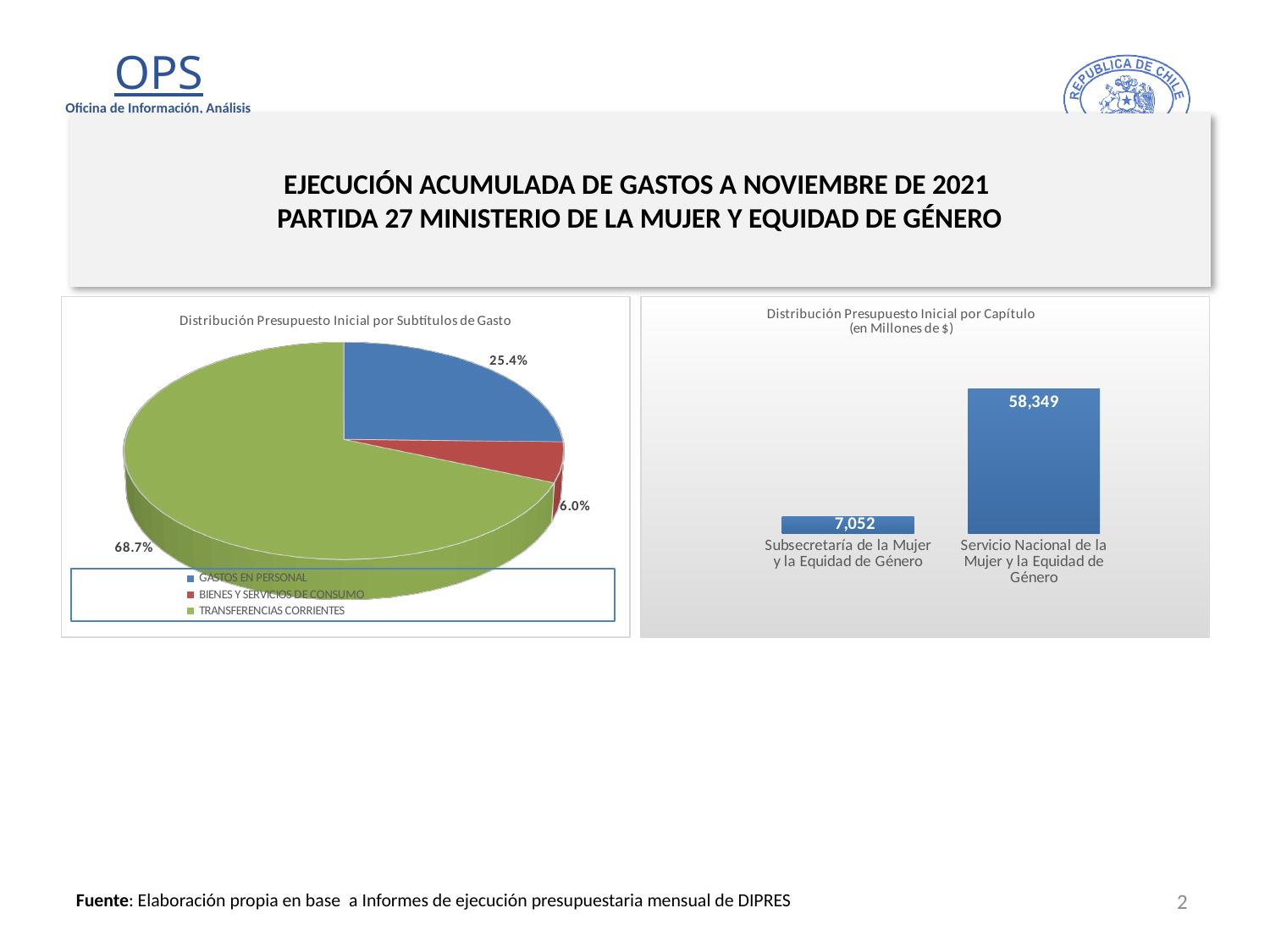
In the chart 'Distribución Presupuesto Inicial por Capítulo', what is the difference between the values for Servicio Nacional de la Mujer y la Equidad de Género and Subsecretaría de la Mujer y la Equidad de Género? 51,297 In the chart 'Distribución Presupuesto Inicial por Capítulo', what is the value for Servicio Nacional de la Mujer y la Equidad de Género? 58,349 In the chart 'Distribución Presupuesto Inicial por Capítulo', what is the value for Subsecretaría de la Mujer y la Equidad de Género? 7,052 In the pie chart 'Distribución Presupuesto Inicial por Subtítulos de Gasto', which category has the largest share? TRANSFERENCIAS CORRIENTES In the chart 'Distribución Presupuesto Inicial por Capítulo', which category has the higher value? Servicio Nacional de la Mujer y la Equidad de Género In the pie chart 'Distribución Presupuesto Inicial por Subtítulos de Gasto', what share does GASTOS EN PERSONAL have? 25.4% In the pie chart 'Distribución Presupuesto Inicial por Subtítulos de Gasto', which category has the smallest share? BIENES Y SERVICIOS DE CONSUMO In the pie chart 'Distribución Presupuesto Inicial por Subtítulos de Gasto', what share does TRANSFERENCIAS CORRIENTES have? 68.7% In the pie chart 'Distribución Presupuesto Inicial por Subtítulos de Gasto', what colour is the TRANSFERENCIAS CORRIENTES slice? Green In the pie chart 'Distribución Presupuesto Inicial por Subtítulos de Gasto', how many categories does the legend list? 3 What kind of chart is 'Distribución Presupuesto Inicial por Capítulo'? Bar chart In the pie chart 'Distribución Presupuesto Inicial por Subtítulos de Gasto', what share does BIENES Y SERVICIOS DE CONSUMO have? 6.0%